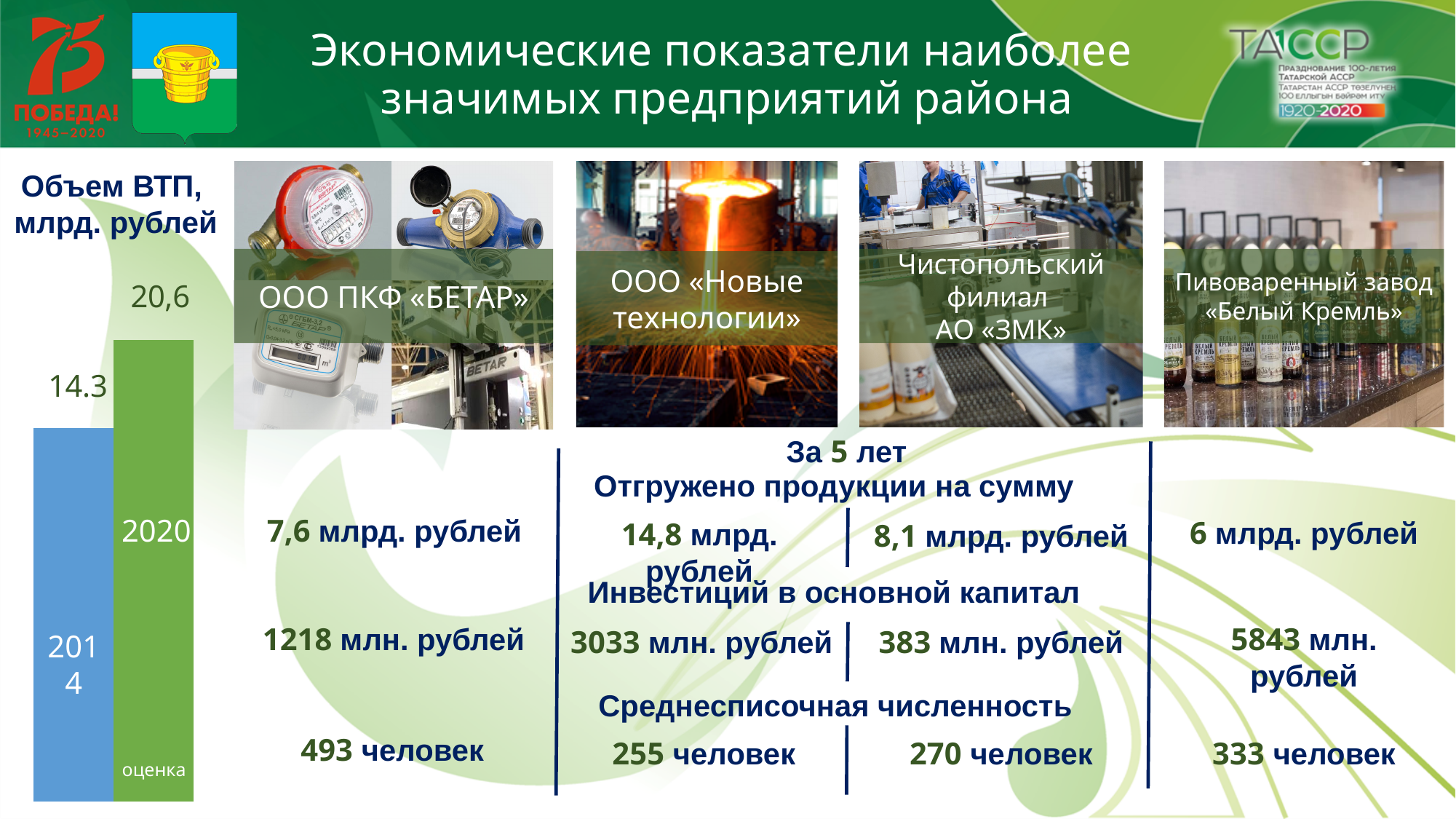
In the bar chart 'Объем ВТП, млрд. рублей', what is the value for 2014? 14.3 In the bar chart 'Объем ВТП, млрд. рублей', is the value for 2020 larger or smaller than the value for 2014? larger In the bar chart 'Объем ВТП, млрд. рублей', by how much does the 2020 value exceed the 2014 value? 6,3 In the chart 'Объем ВТП, млрд. рублей', does the value rise or fall from 2014 to 2020? rise How many bars are shown in the chart 'Объем ВТП, млрд. рублей'? 2 What kind of chart is used to show 'Объем ВТП, млрд. рублей'? bar chart In the bar chart 'Объем ВТП, млрд. рублей', which year has the lower value? 2014 In the bar chart 'Объем ВТП, млрд. рублей', which year has the higher value? 2020 What is the title of the bar chart on the left of the slide? Объем ВТП, млрд. рублей In the bar chart 'Объем ВТП, млрд. рублей', what word is printed at the bottom of the 2020 bar? оценка In the bar chart 'Объем ВТП, млрд. рублей', what is the value for 2020? 20,6